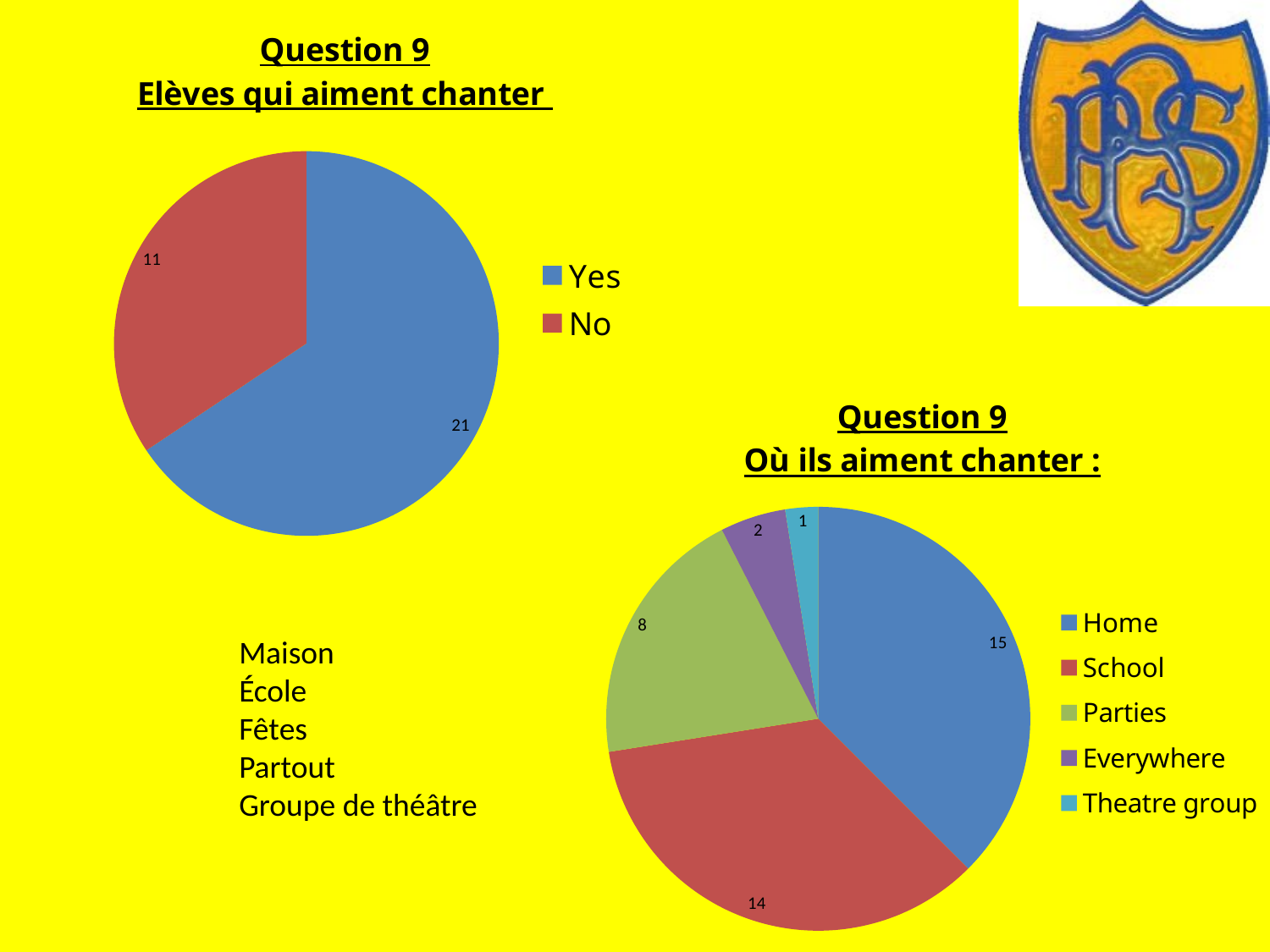
In the 'Où ils aiment chanter' pie chart, what is the value for Everywhere? 2 In the 'Où ils aiment chanter' pie chart, what is the difference between the values for Home and Parties? 7 In the 'Où ils aiment chanter' pie chart, which category has the largest value? Home What type of chart is used for 'Elèves qui aiment chanter'? Pie chart In the 'Où ils aiment chanter' pie chart, what share of the total does Home represent? 37.5% In the 'Où ils aiment chanter' pie chart, what is the value for Parties? 8 In the 'Où ils aiment chanter' pie chart, which category has the smallest slice? Theatre group In the 'Elèves qui aiment chanter' pie chart, how many students answered No? 11 In the 'Elèves qui aiment chanter' pie chart, which answer has the larger slice, Yes or No? Yes In the 'Où ils aiment chanter' pie chart, how many categories does the legend list? 5 In the 'Elèves qui aiment chanter' pie chart, what is the difference between the Yes and No counts? 10 In the 'Elèves qui aiment chanter' pie chart, how many students answered Yes? 21